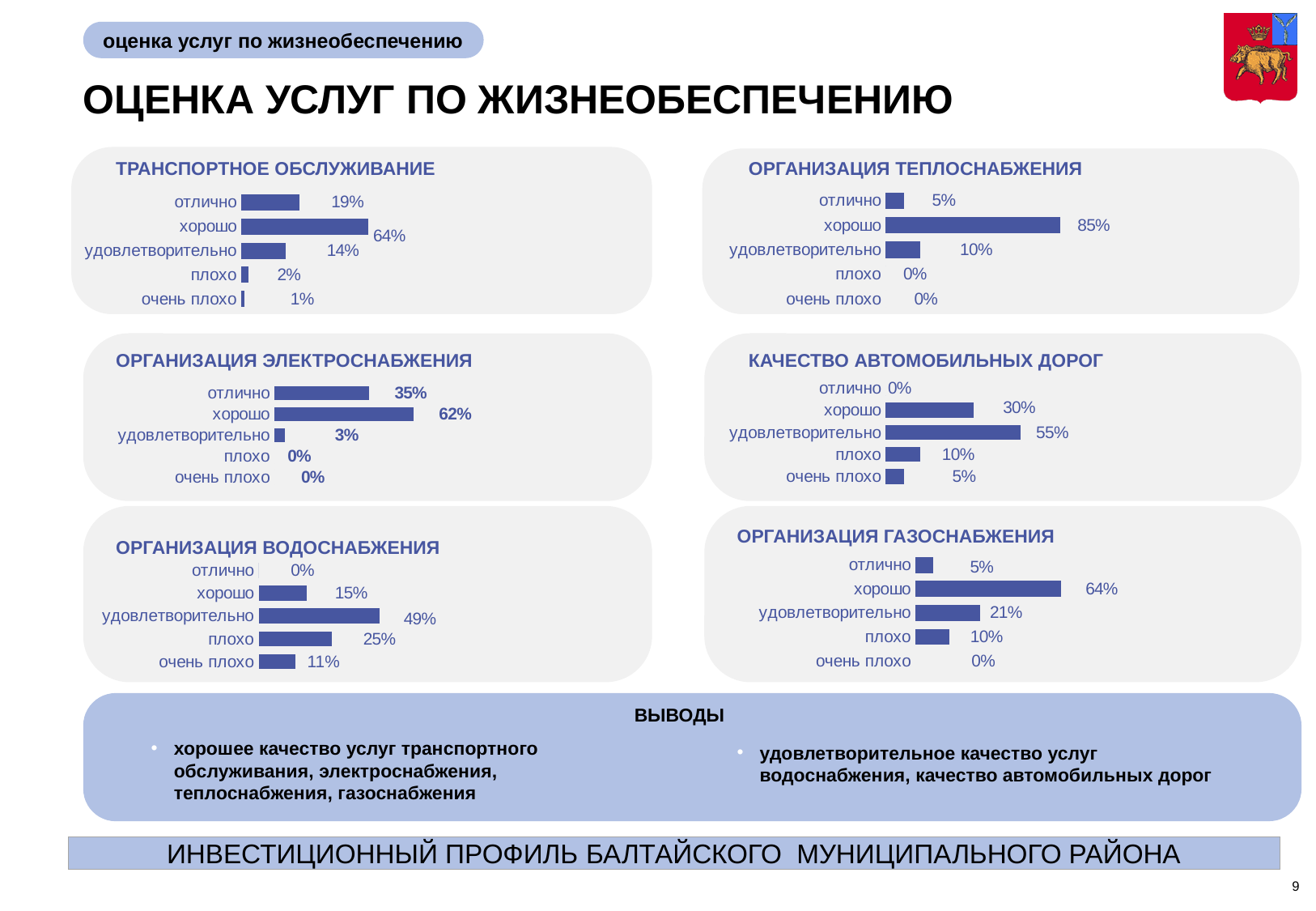
In the 'ОРГАНИЗАЦИЯ ЭЛЕКТРОСНАБЖЕНИЯ' chart, what is the value for 'отлично'? 35% In the 'ОРГАНИЗАЦИЯ ВОДОСНАБЖЕНИЯ' chart, what is the difference between 'удовлетворительно' and 'плохо'? 24% How many bar charts are shown on the slide? 6 In the 'КАЧЕСТВО АВТОМОБИЛЬНЫХ ДОРОГ' chart, which category has the highest value? удовлетворительно In the 'КАЧЕСТВО АВТОМОБИЛЬНЫХ ДОРОГ' chart, what is the value for 'очень плохо'? 5% In the 'ОРГАНИЗАЦИЯ ТЕПЛОСНАБЖЕНИЯ' chart, which category has the highest value? хорошо How many categories are shown in the 'ОРГАНИЗАЦИЯ ВОДОСНАБЖЕНИЯ' chart? 5 In the 'ОРГАНИЗАЦИЯ ЭЛЕКТРОСНАБЖЕНИЯ' chart, what is the difference between 'хорошо' and 'отлично'? 27% What type of chart is used for 'ОРГАНИЗАЦИЯ ТЕПЛОСНАБЖЕНИЯ'? Bar chart In the 'ТРАНСПОРТНОЕ ОБСЛУЖИВАНИЕ' chart, which is larger: 'отлично' or 'удовлетворительно'? отлично In the 'ОРГАНИЗАЦИЯ ГАЗОСНАБЖЕНИЯ' chart, what is the value for 'удовлетворительно'? 21% In the 'ТРАНСПОРТНОЕ ОБСЛУЖИВАНИЕ' chart, what is the value for 'хорошо'? 64%